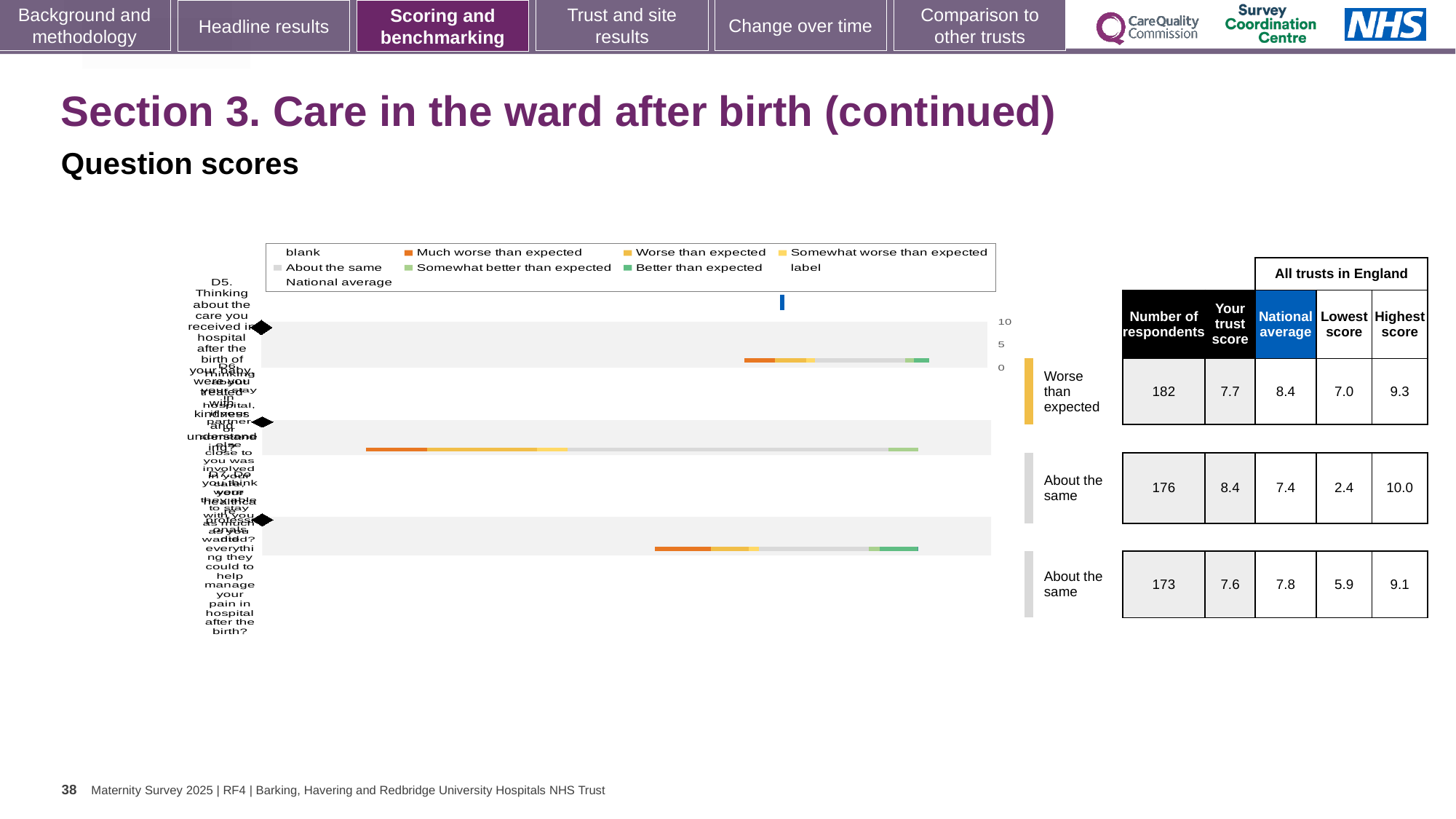
For the second question row, which is larger: the trust score or the national average? the trust score (8.4) What is the smallest 'Lowest score' value shown in the table? 2.4 Which question row has the highest 'Highest score' value? the second row (10.0) What is the national average for the third (bottom) question row? 7.8 What is the number of respondents for the first (top) question row? 182 For the first question row, what is the difference between the national average and the trust score? 0.7 What colour represents 'Much worse than expected' in the legend? orange What is the trust score for the second question row? 8.4 How many question rows are plotted in the chart? 3 What kind of chart is shown on the slide? bar chart What is the lowest score among all trusts in England for the third question row? 5.9 What benchmark category is the first (top) question row rated as? Worse than expected